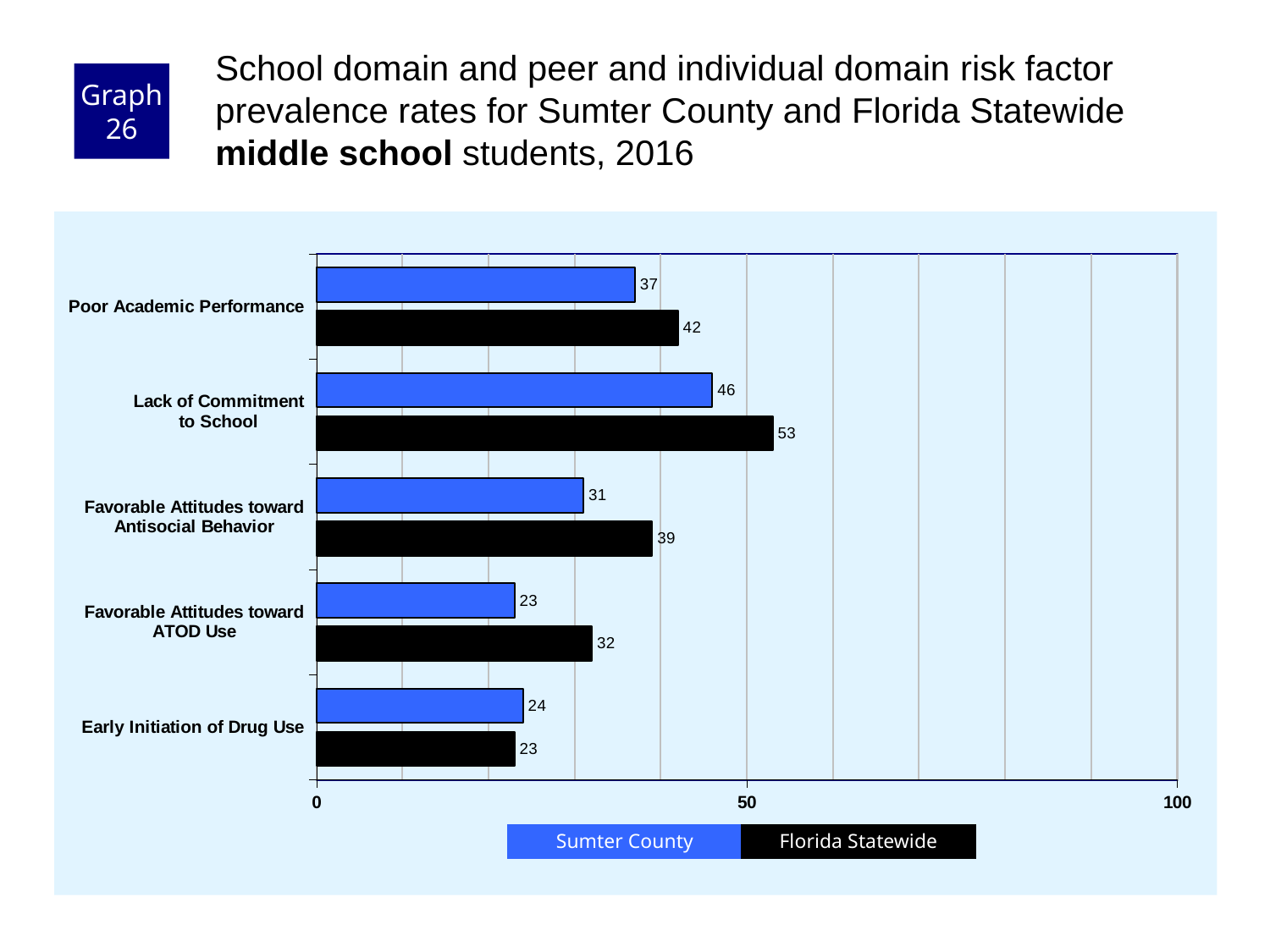
What is the Sumter County value for Lack of Commitment to School? 46 Is the Florida Statewide value for Lack of Commitment to School greater or less than 50? greater What kind of chart is shown on the slide? bar chart Which risk factor has the highest Florida Statewide value? Lack of Commitment to School What is the difference between the Florida Statewide and Sumter County values for Favorable Attitudes toward ATOD Use? 9 Which colour represents Sumter County in the chart? blue Which risk factor has the lowest Sumter County value? Favorable Attitudes toward ATOD Use What is the Florida Statewide value for Favorable Attitudes toward Antisocial Behavior? 39 How many risk factor categories are shown on the chart? 5 How many series does the legend list? 2 For Poor Academic Performance, which is larger: the Sumter County value or the Florida Statewide value? Florida Statewide What is the Sumter County value for Early Initiation of Drug Use? 24